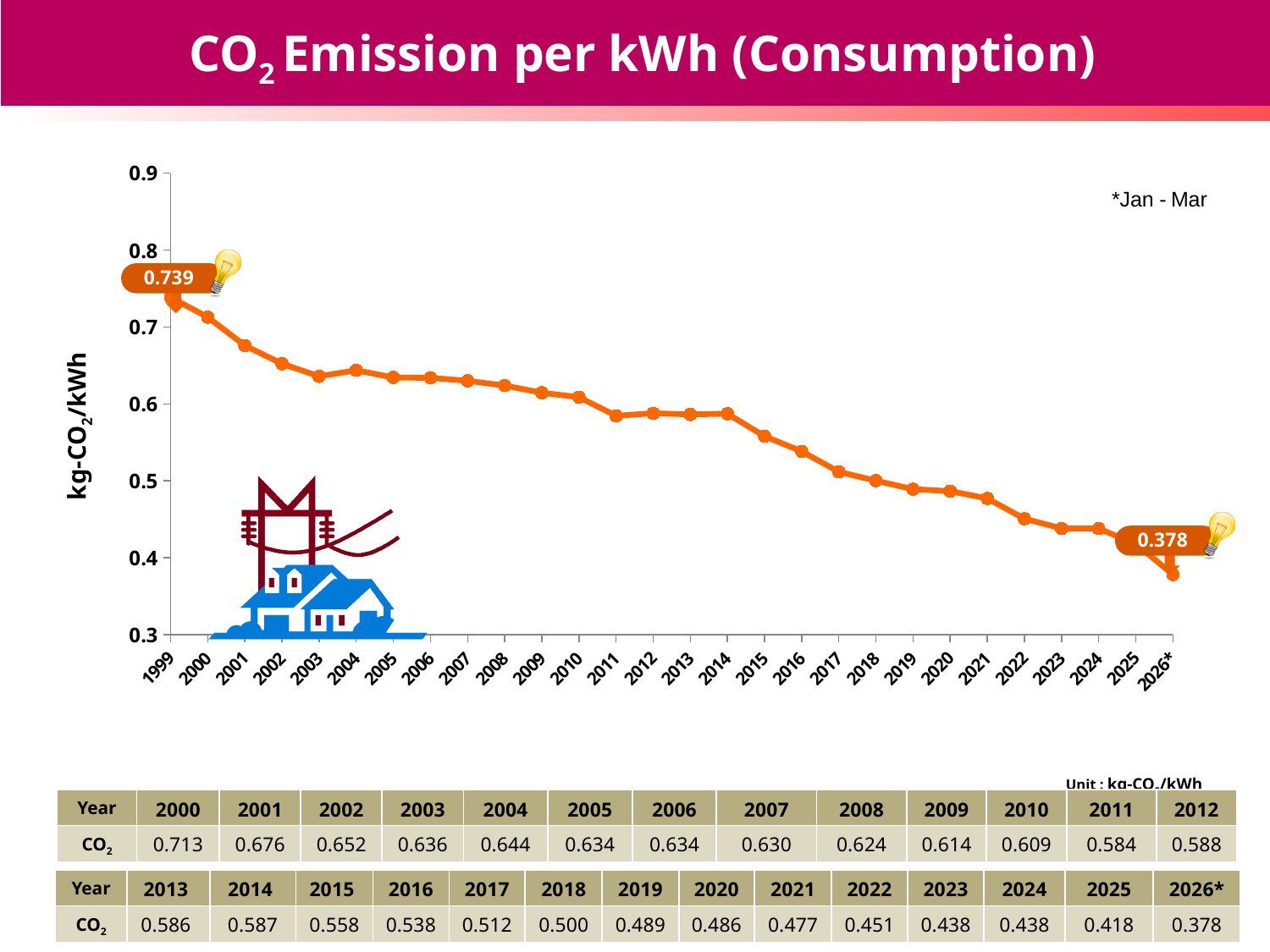
What is the CO2 emission per kWh value shown for 1999? 0.739 What is the difference between the 1999 value (0.739) and the 2026* value (0.378)? 0.361 What kind of chart is shown on the slide? line chart Which year has a higher CO2 emission per kWh, 2005 or 2015? 2005 Do the values generally rise or fall from 1999 to 2026*? fall Is the value for 2017 greater or less than 0.6? less According to the table, what was the CO2 emission per kWh in 2010? 0.609 What is the CO2 emission per kWh value shown for 2026*? 0.378 Which year has the highest CO2 emission per kWh on the chart? 1999 Which year has the lowest CO2 emission per kWh on the chart? 2026* How many years are plotted on the x axis of the chart? 28 According to the table, what was the CO2 emission per kWh in 2020? 0.486